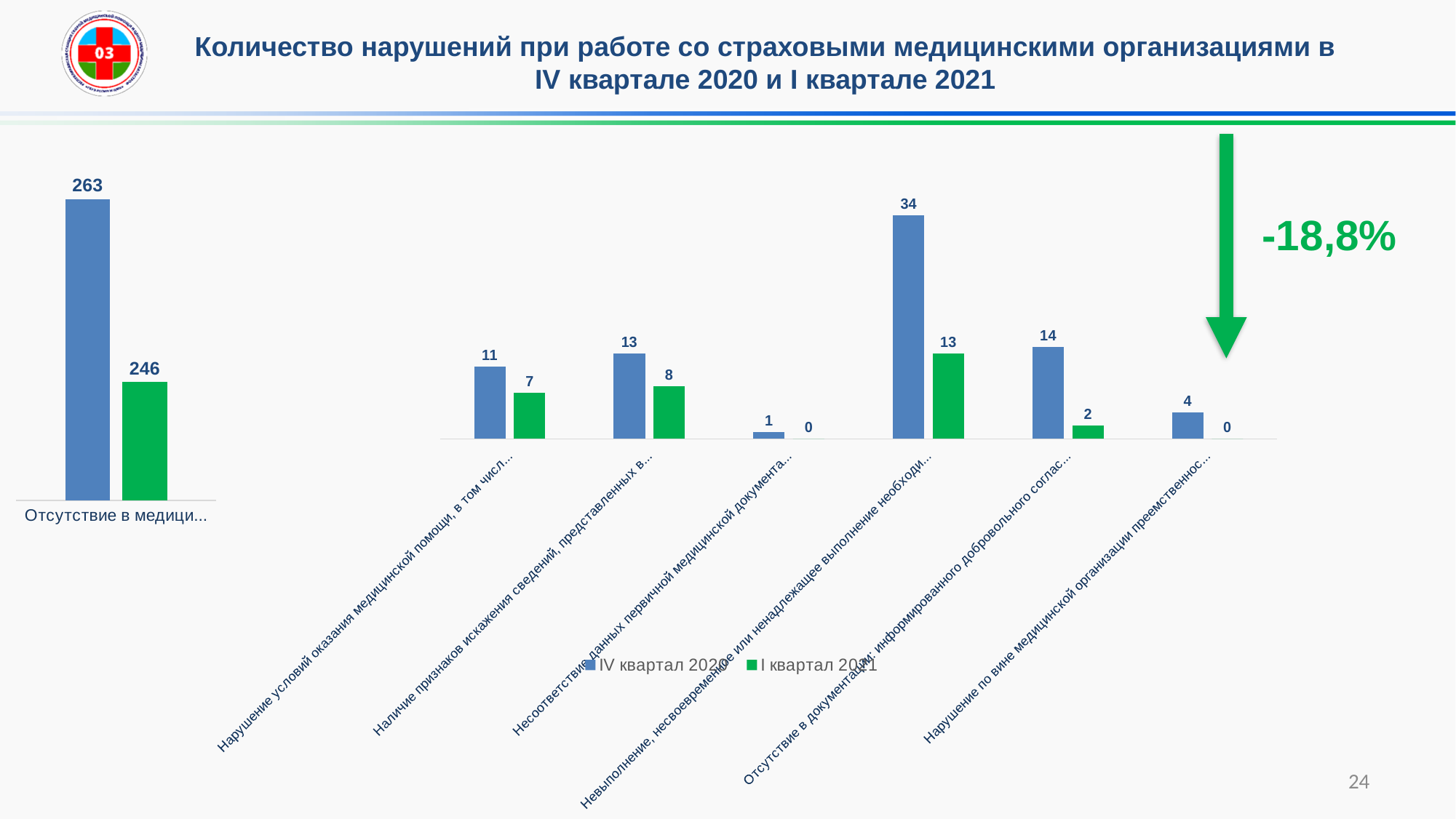
On the left chart, what is the value for I квартал 2021? 246 On the right chart, what is the difference between the IV квартал 2020 and I квартал 2021 values for the category starting 'Отсутствие в документации информированного добровольного'? 12 On the right chart, which category has the lowest IV квартал 2020 value? Несоответствие данных первичной медицинской документа... On the left chart, what is the difference between the IV квартал 2020 value and the I квартал 2021 value? 17 How many categories are shown on the right chart? 6 On the right chart, what is the IV квартал 2020 value for the category starting 'Невыполнение, несвоевременное или ненадлежащее выполнение'? 34 On the right chart, which category has the highest IV квартал 2020 value? Невыполнение, несвоевременное или ненадлежащее выполнение необходи... On the left chart, what is the value for IV квартал 2020 for the category 'Отсутствие в медици...'? 263 What type of chart is the right chart? Bar chart How many series does the legend of the right chart list? 2 On the right chart, which is larger for the category starting 'Нарушение условий оказания медицинской помощи': the IV квартал 2020 value or the I квартал 2021 value? IV квартал 2020 On the right chart, what is the I квартал 2021 value for the category starting 'Наличие признаков искажения сведений'? 8